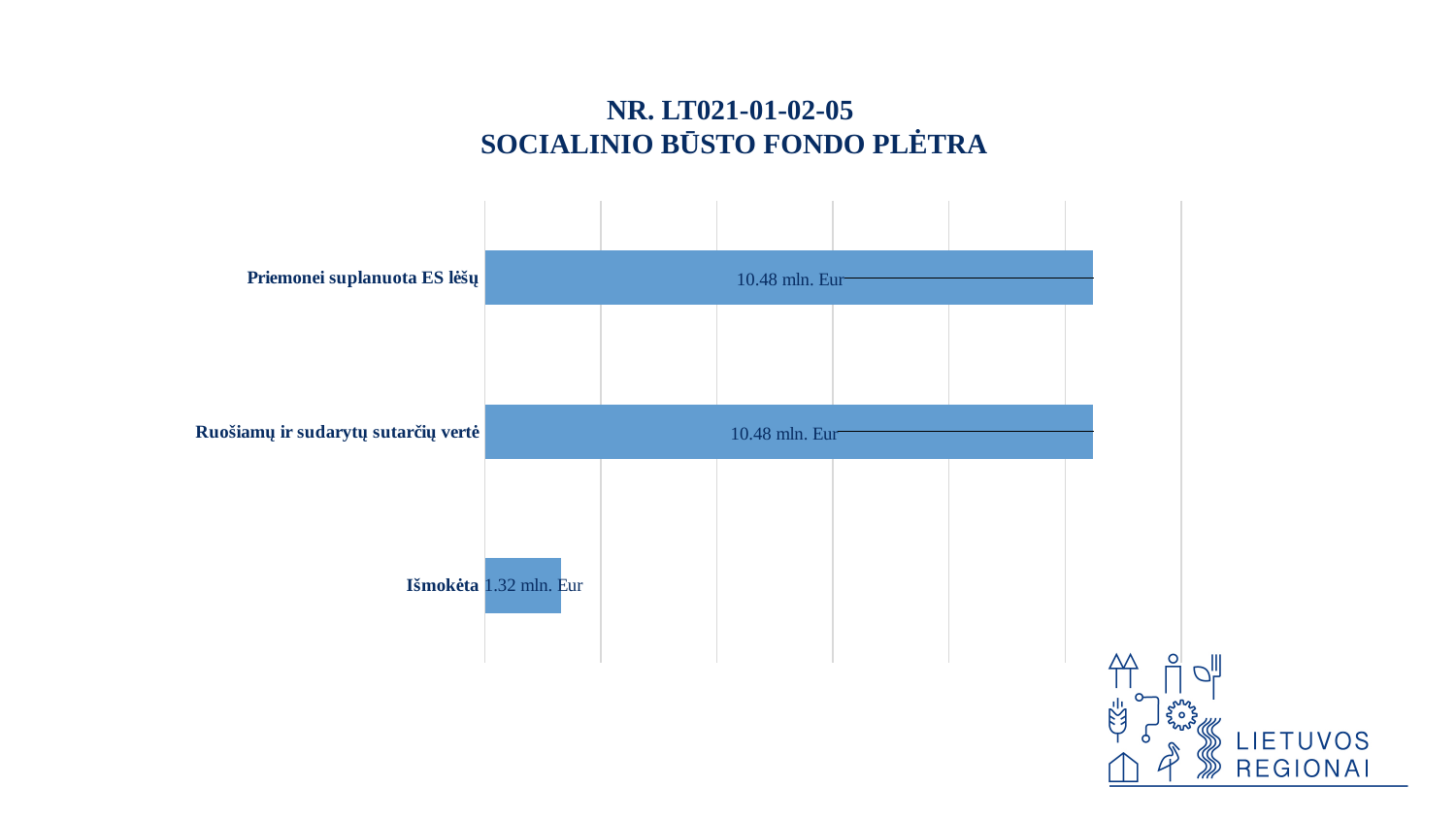
Which is larger: the value for "Ruošiamų ir sudarytų sutarčių vertė" or the value for "Išmokėta"? Ruošiamų ir sudarytų sutarčių vertė What is the difference between the value for "Priemonei suplanuota ES lėšų" and the value for "Išmokėta"? 9.16 mln. Eur What is the value for "Ruošiamų ir sudarytų sutarčių vertė"? 10.48 mln. Eur Are the bars in the chart horizontal or vertical? Horizontal What kind of chart is shown on the slide? Bar chart What is the value for "Išmokėta"? 1.32 mln. Eur How many categories are shown in the chart? 3 Which category has the lowest value? Išmokėta Do "Priemonei suplanuota ES lėšų" and "Ruošiamų ir sudarytų sutarčių vertė" have the same value? Yes What is the value for "Priemonei suplanuota ES lėšų"? 10.48 mln. Eur What is the title of the slide above the chart? NR. LT021-01-02-05 SOCIALINIO BŪSTO FONDO PLĖTRA